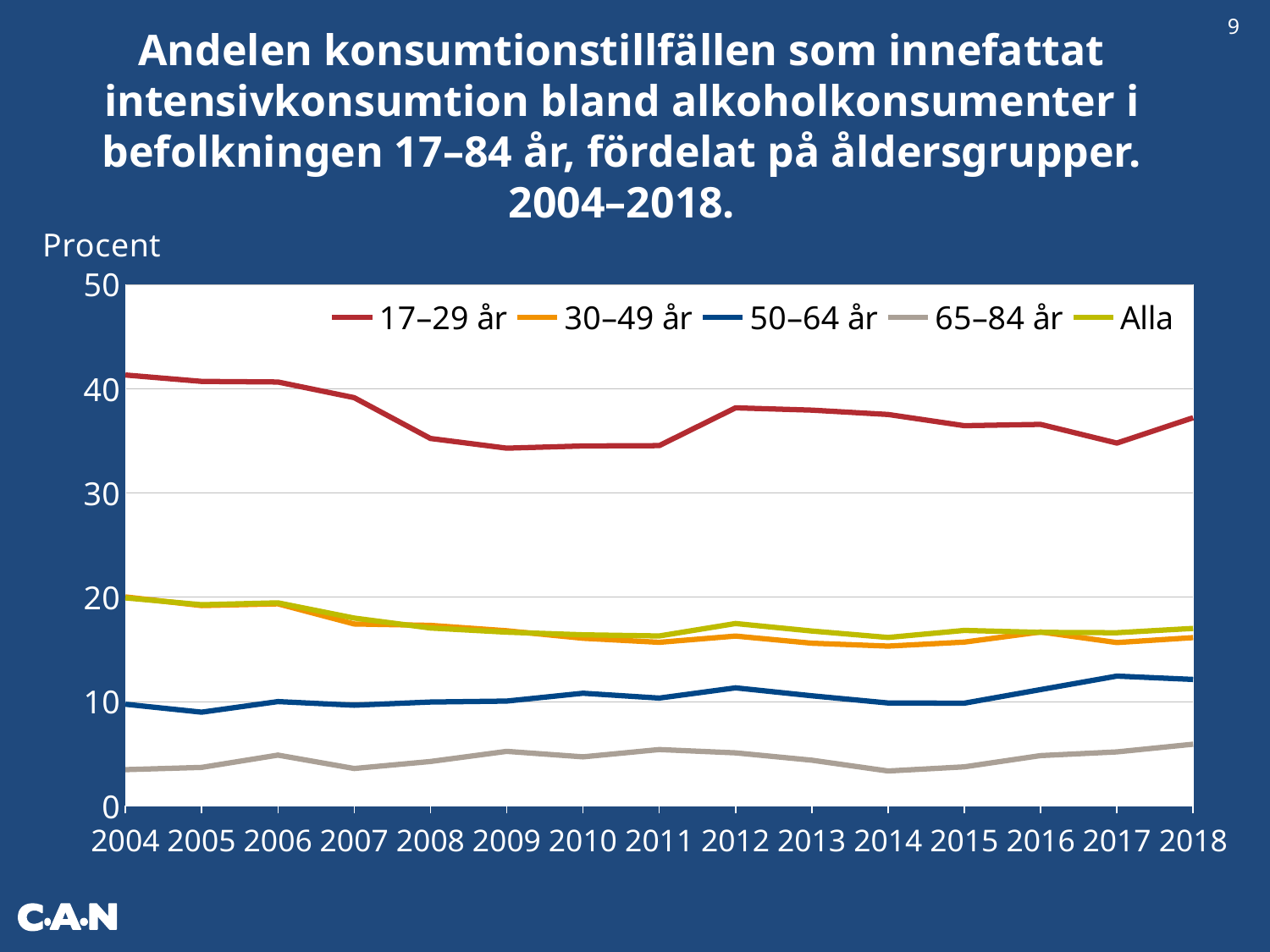
Which age group has the lowest values across the whole period? 65–84 år Does the 17–29 år line rise or fall between 2004 and 2009? fall For 17–29 år, which year has the larger value, 2004 or 2018? 2004 What kind of chart is shown on the slide? line chart What label is shown on the vertical axis? Procent Is the value for 17–29 år in 2004 greater or less than 40? greater Is the value for 17–29 år in 2009 greater or less than 40? less How many series does the legend list? 5 Which age group has the highest values across the whole period? 17–29 år Is the value for 65–84 år in 2018 greater or less than 10? less How many years are plotted along the x axis? 15